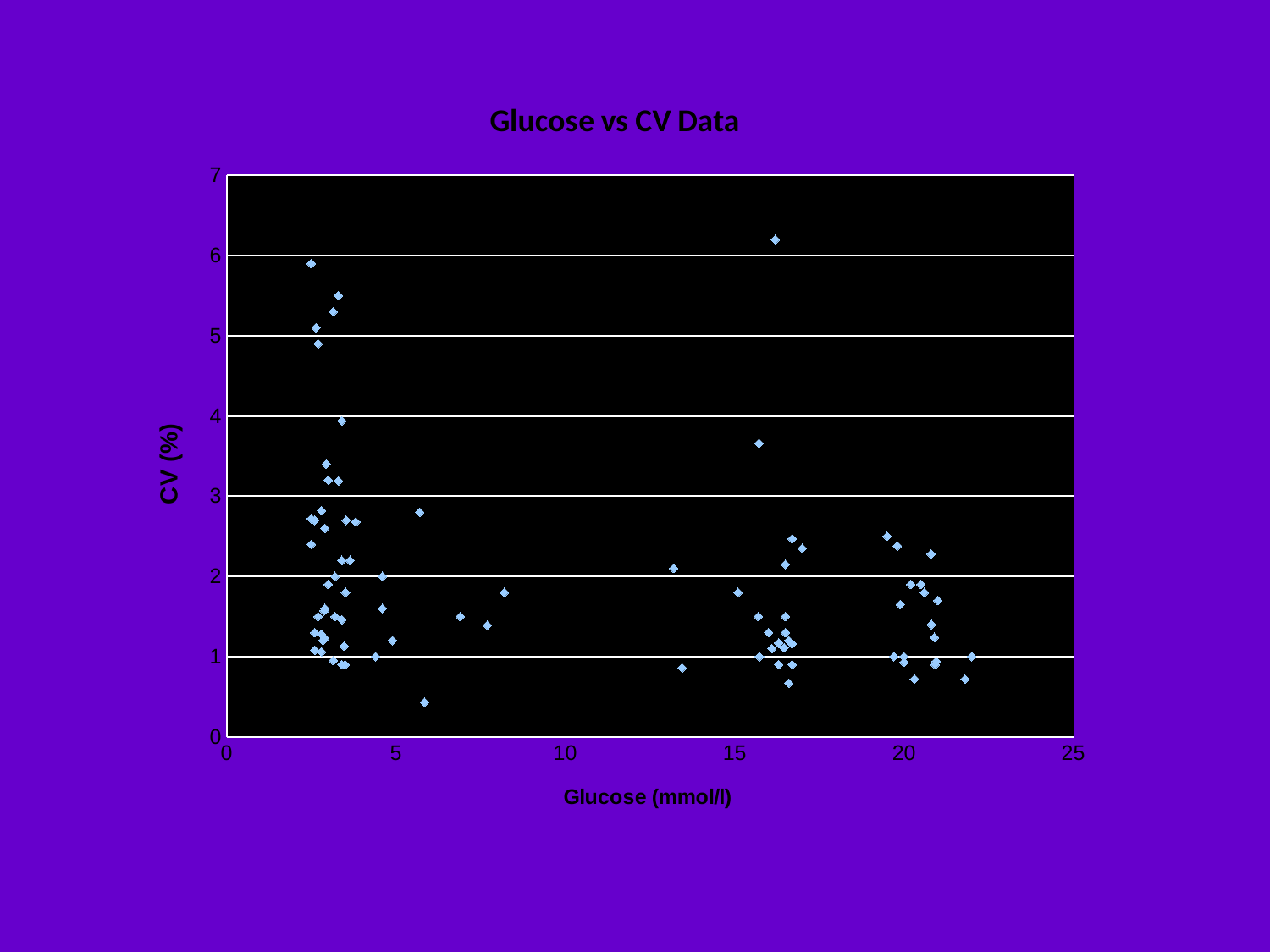
Is the point with the highest CV located at a glucose value greater or less than 15? greater What is the title of the chart? Glucose vs CV Data Is the smallest glucose value plotted greater or less than 5? less Is the highest CV value among points with glucose below 5 greater or less than 5? greater What is the label of the x axis? Glucose (mmol/l) What kind of chart is shown on the slide? scatter chart